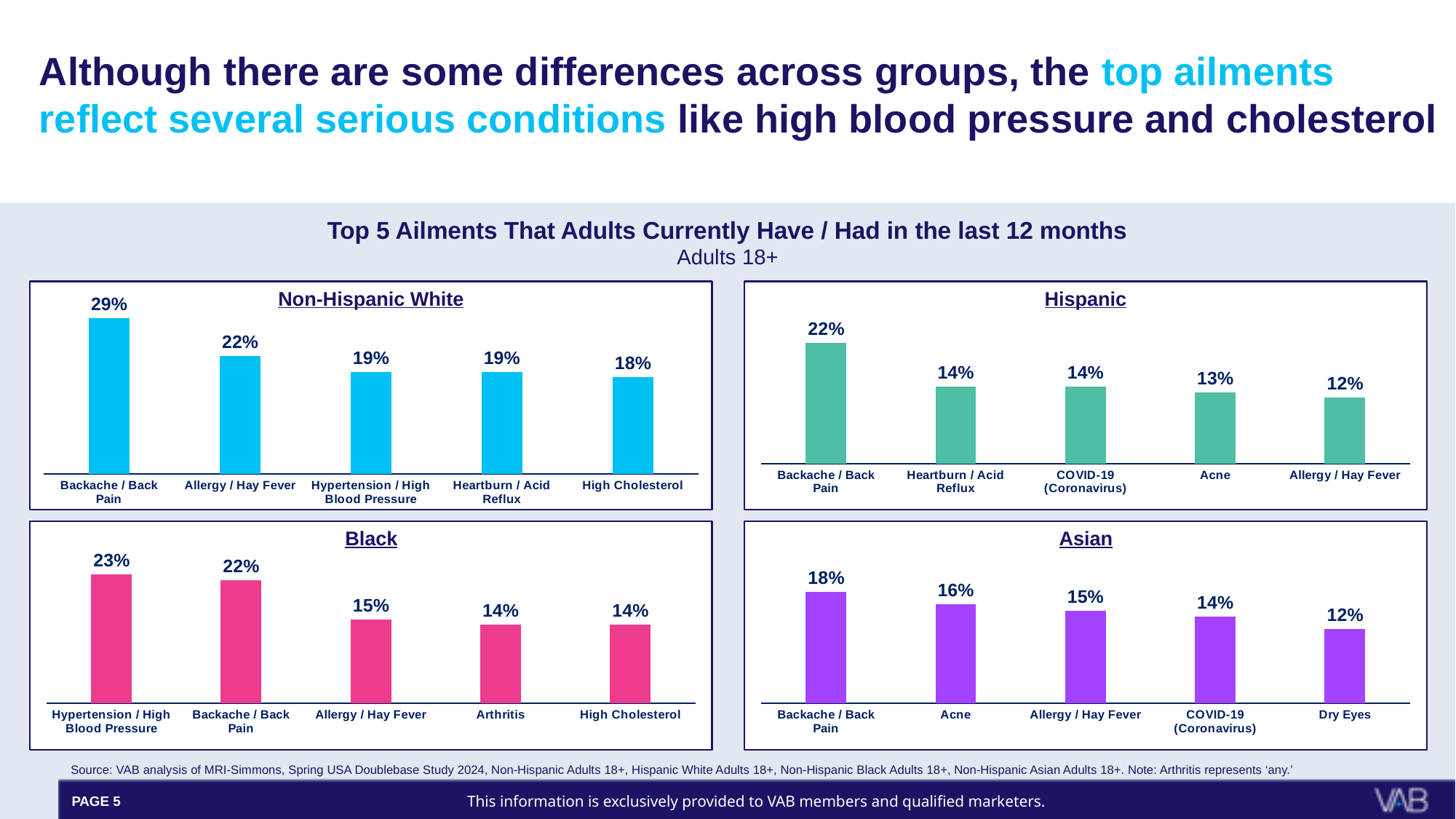
In the Black chart, what is the value for Arthritis? 14% What type of chart is the Black chart? Bar chart How many ailments are shown in the Asian chart? 5 In the Asian chart, do the values rise or fall from left to right? Fall In the Asian chart, what is the difference between Backache / Back Pain and Acne? 2% In the Non-Hispanic White chart, what is the difference between Backache / Back Pain and High Cholesterol? 11% In the Hispanic chart, what is the value for Acne? 13% In the Non-Hispanic White chart, what is the value for Backache / Back Pain? 29% In the Black chart, which ailment has the highest value? Hypertension / High Blood Pressure In the Asian chart, which ailment has the lowest value? Dry Eyes In the Hispanic chart, which is larger: Backache / Back Pain or Allergy / Hay Fever? Backache / Back Pain What colour are the bars in the Hispanic chart? Green